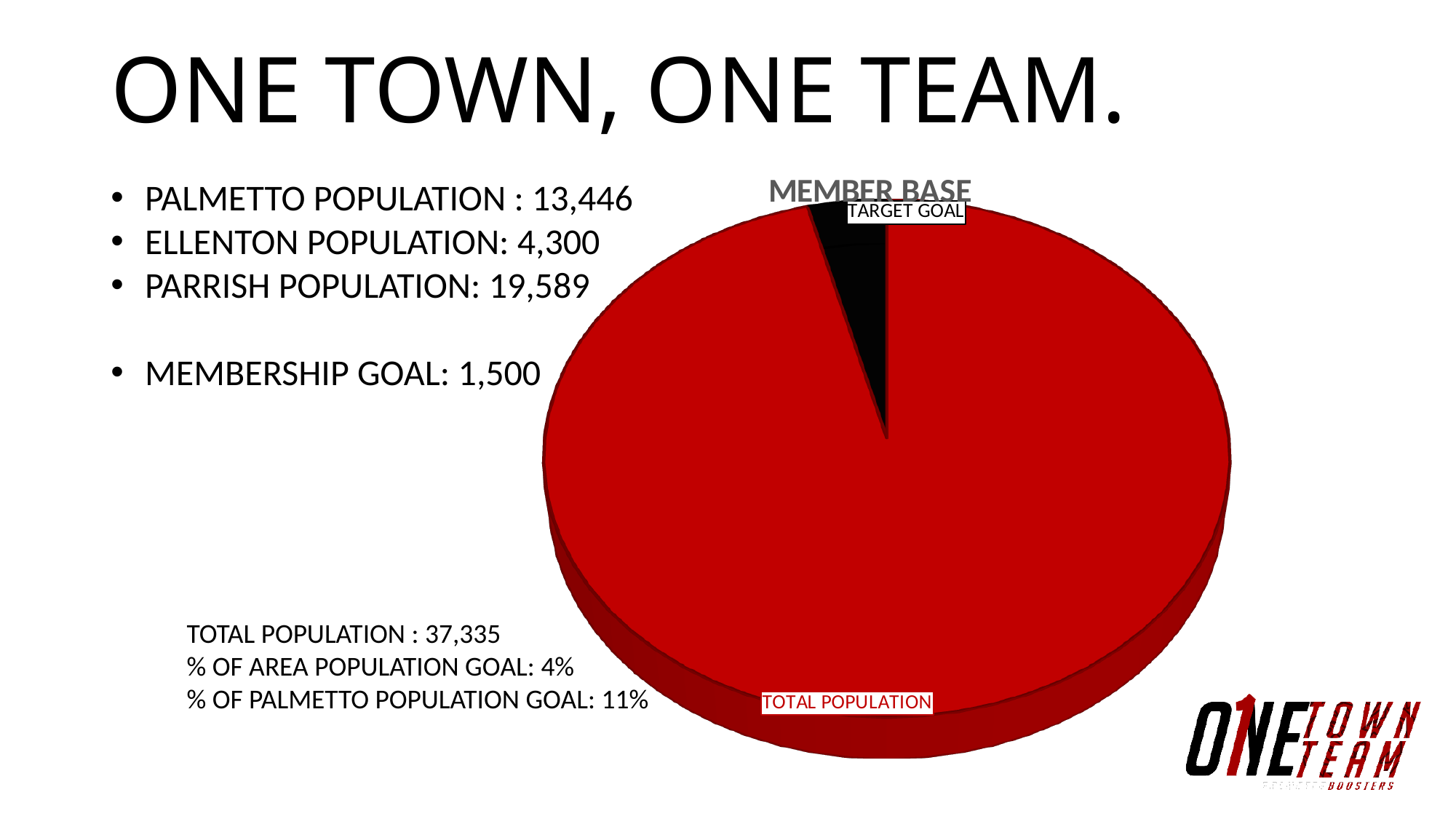
How many slices does the MEMBER BASE pie chart have? 2 What are the labels of the two slices in the MEMBER BASE pie chart? TARGET GOAL and TOTAL POPULATION Which slice of the MEMBER BASE pie chart is the largest? TOTAL POPULATION What colour is the TOTAL POPULATION slice in the MEMBER BASE pie chart? red In the MEMBER BASE pie chart, which slice is larger: TARGET GOAL or TOTAL POPULATION? TOTAL POPULATION What is the title of the pie chart? MEMBER BASE Which slice of the MEMBER BASE pie chart is the smallest? TARGET GOAL What kind of chart is shown on the slide? pie chart